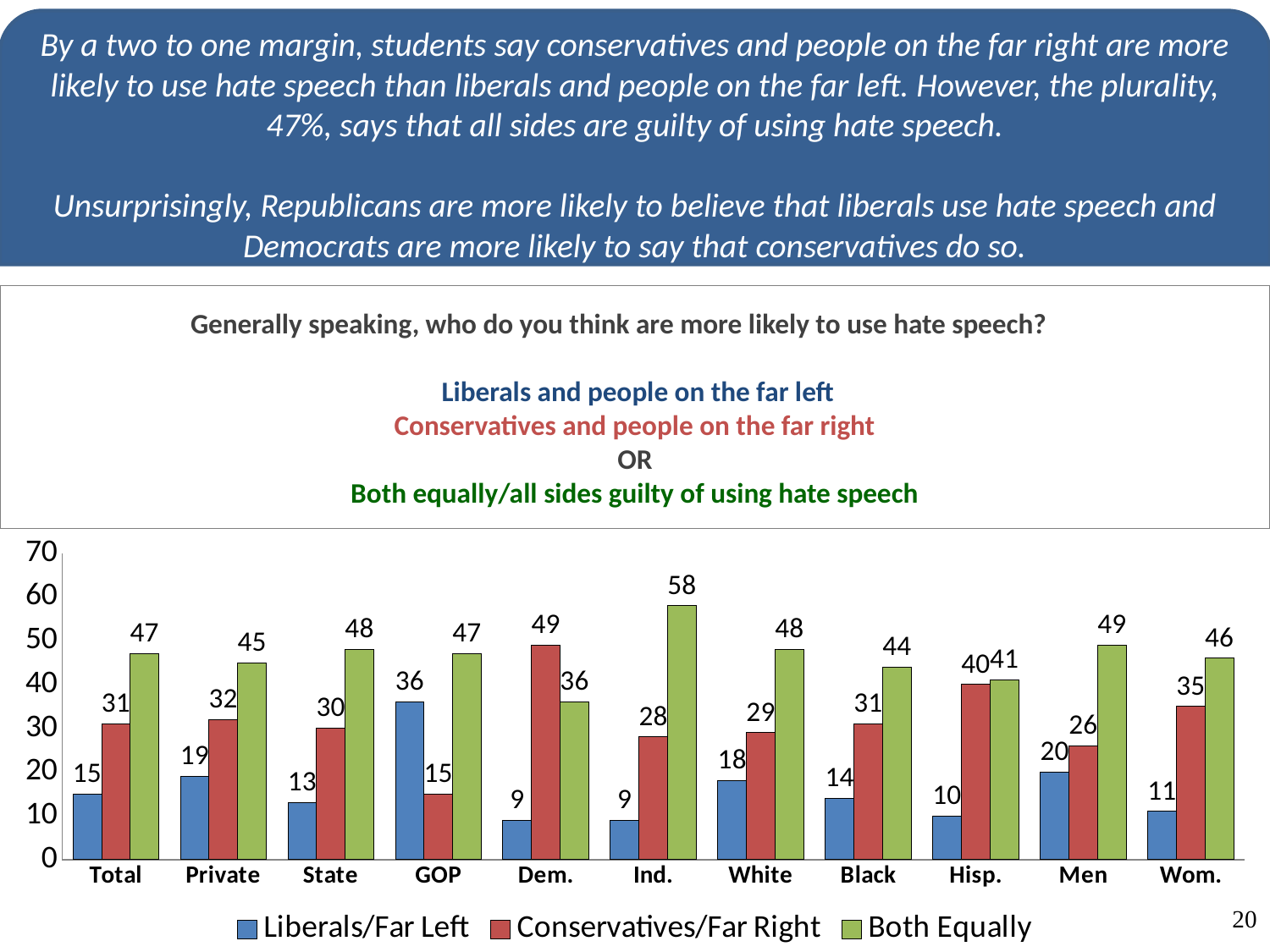
Which category has the lowest value for Conservatives/Far Right? GOP In the Hisp. category, which is larger: Conservatives/Far Right or Both Equally? Both Equally What is the value for Conservatives/Far Right in the Dem. category? 49 What is the value for Liberals/Far Left in the GOP category? 36 What is the value for Both Equally in the Ind. category? 58 How many categories are shown on the x axis? 11 Which category has the highest value for Both Equally? Ind. Is the value for Both Equally in the Men category greater or less than 40? greater How many series does the legend list? 3 What kind of chart is shown on the slide? Bar chart What is the difference between the Conservatives/Far Right and Liberals/Far Left values in the Total category? 16 Which series is shown in green in the legend? Both Equally